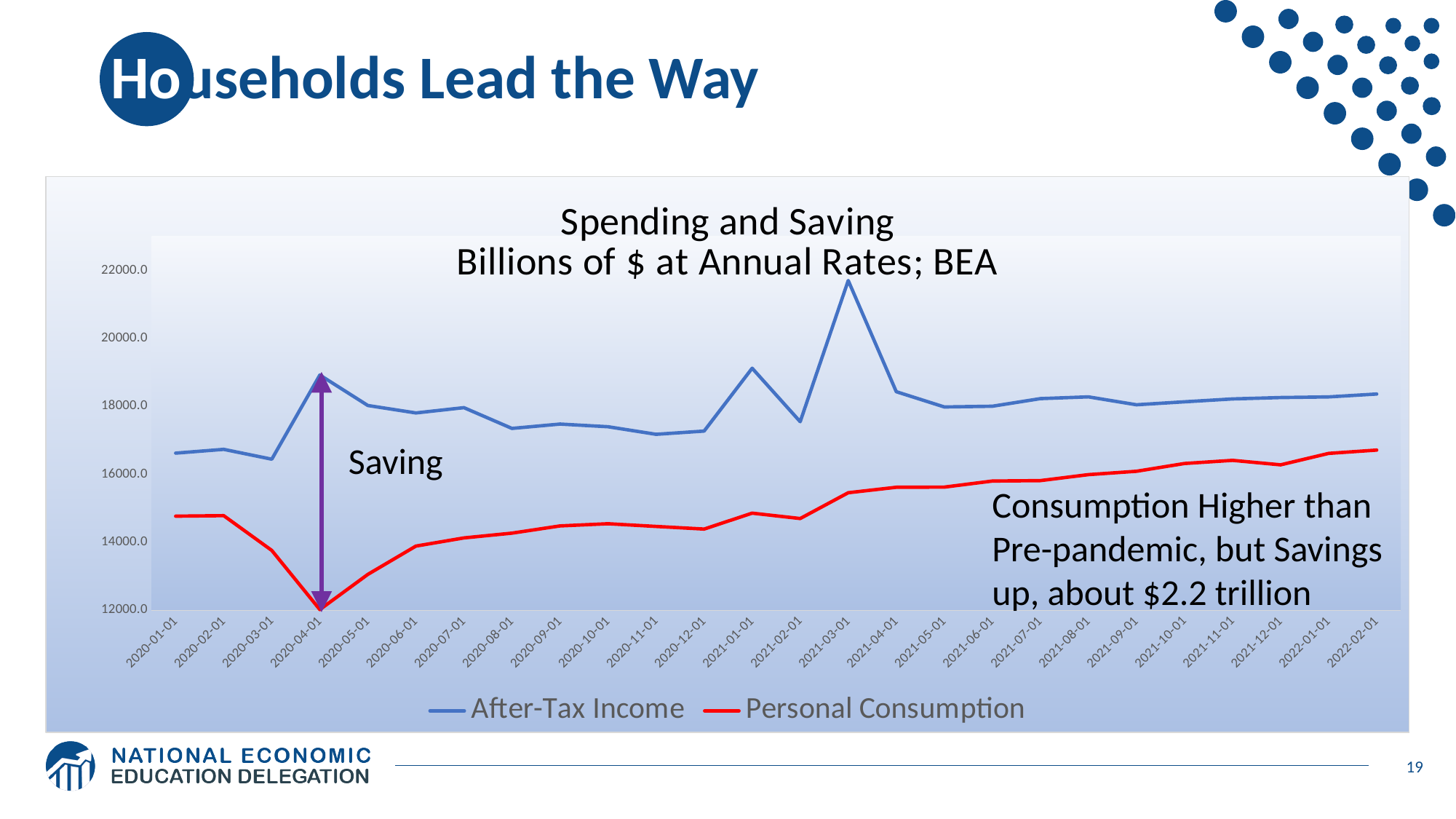
Is the value for Personal Consumption on 2022-02-01 greater or less than 16000.0? greater Does Personal Consumption generally rise or fall from 2020-04-01 to 2022-02-01? Rise On which date does Personal Consumption reach its lowest value? 2020-04-01 What kind of chart is shown on the slide? Line chart Is the value for Personal Consumption on 2020-04-01 greater or less than 14000.0? less How many series does the chart legend list? 2 How many dates are shown along the x axis of the chart? 26 Is the value for After-Tax Income on 2021-03-01 greater or less than 20000.0? greater What is the title of the chart? Spending and Saving Billions of $ at Annual Rates; BEA On which date does After-Tax Income reach its highest value? 2021-03-01 On 2020-04-01, which is larger: After-Tax Income or Personal Consumption? After-Tax Income